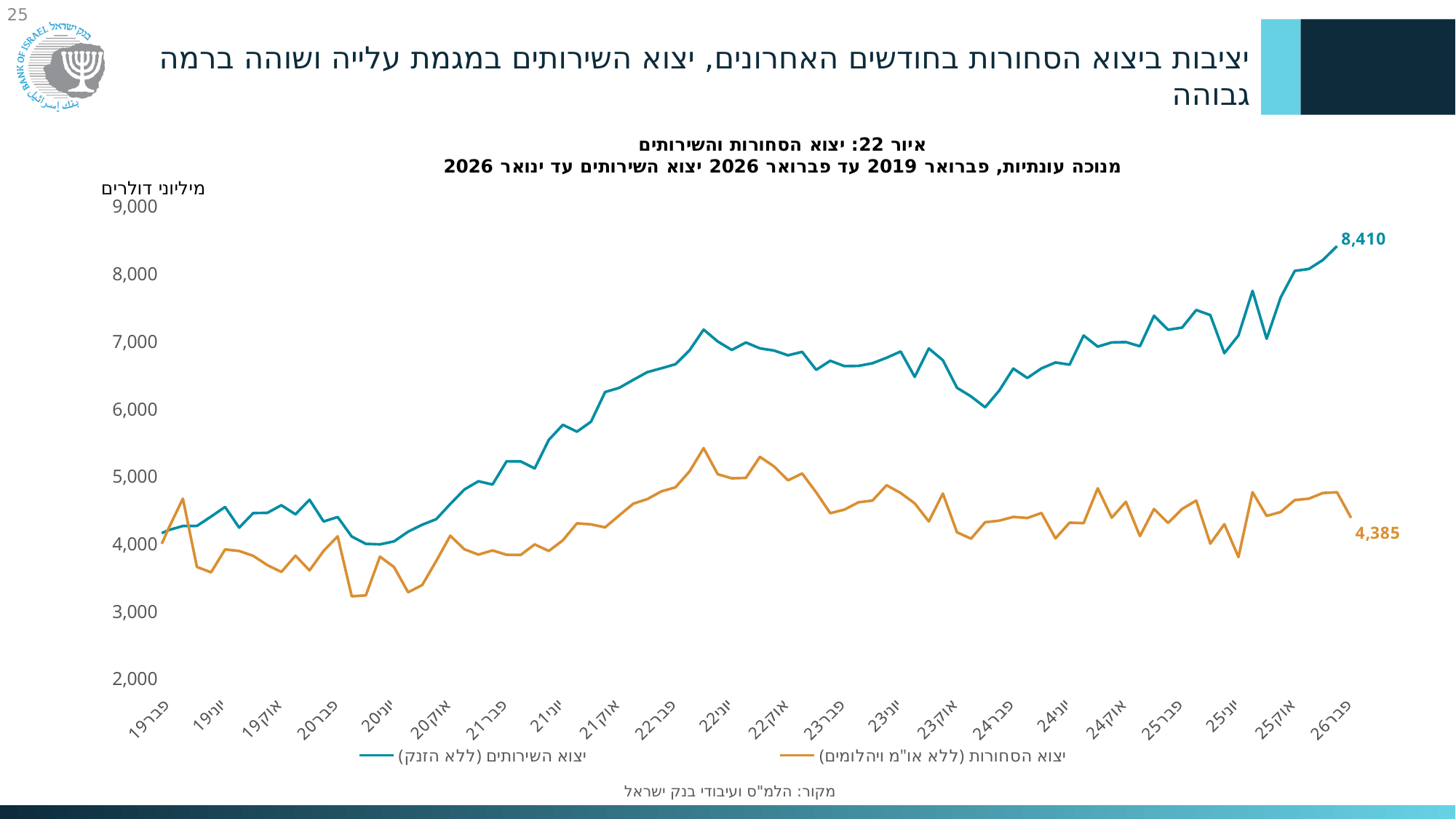
Does the services exports series generally rise or fall from פבר19 to פבר26? Rise How many series does the chart's legend list? 2 Is the value of the services exports series at פבר19 greater or less than 5,000? less Which series has the higher labelled end value: services exports or goods exports? Services exports (יצוא השירותים) What is the latest labelled value of the services exports series (יצוא השירותים (ללא הזנק)) in the chart? 8,410 Is the value of the services exports series at פבר22 greater or less than 6,000? greater Is the value of the goods exports series at יוני20 greater or less than 4,000? less What is the latest labelled value of the goods exports series (יצוא הסחורות (ללא או"מ ויהלומים)) in the chart? 4,385 What kind of chart is shown on the slide? Line chart What is the figure number given in the chart title? איור 22 What unit is shown on the y axis of the chart? מיליוני דולרים What is the difference between the two labelled end values, 8,410 for services exports and 4,385 for goods exports? 4,025